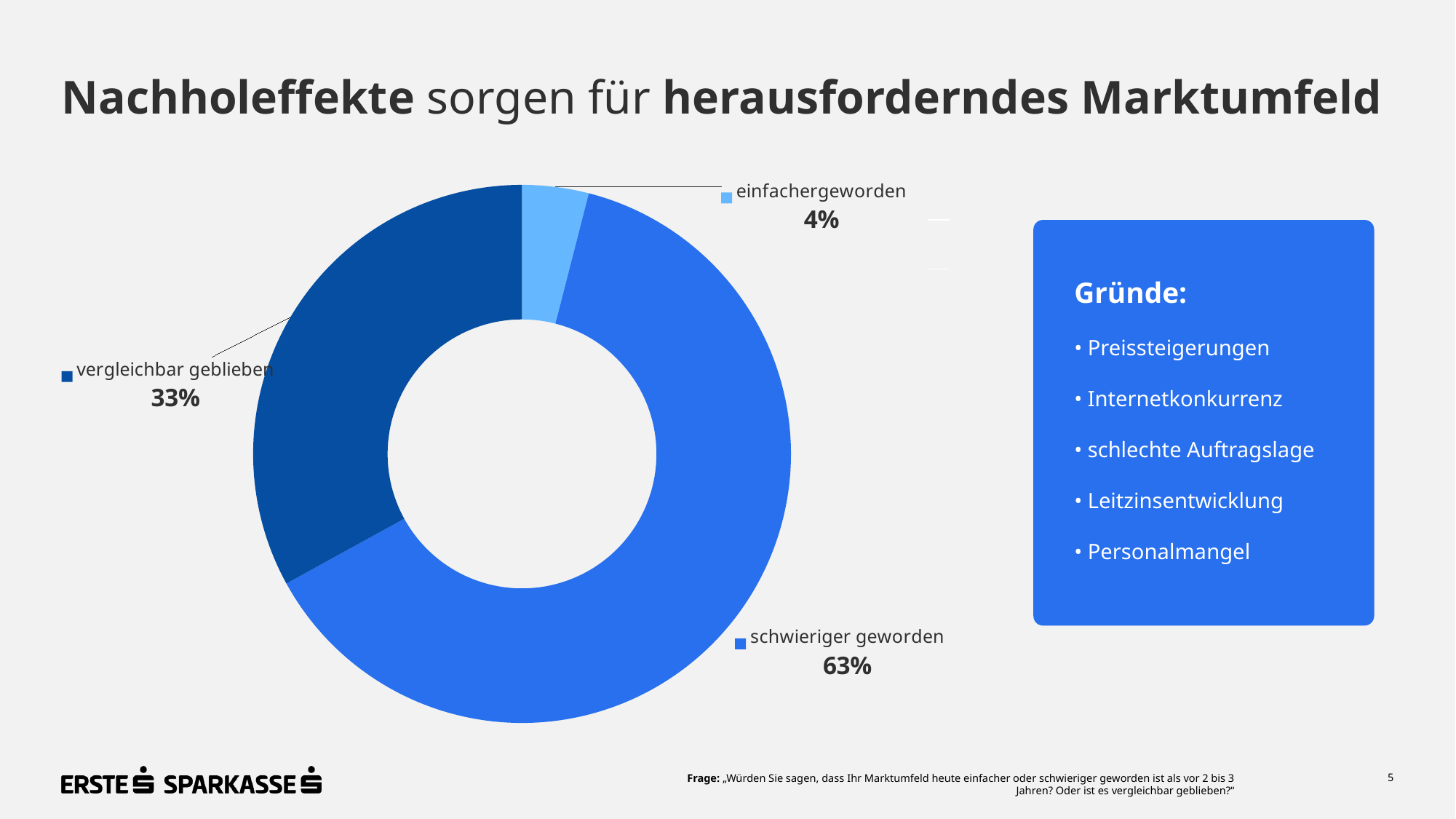
How many reasons are listed in the 'Gründe' box next to the chart? 5 What percentage of respondents said their market environment has become 'schwieriger geworden'? 63% What is the difference in percentage points between 'schwieriger geworden' and 'vergleichbar geblieben'? 30 What percentage is shown for 'einfacher geworden'? 4% What percentage is shown for 'vergleichbar geblieben'? 33% What is the difference in percentage points between 'vergleichbar geblieben' and 'einfacher geworden'? 29 Which category has the smallest share of the chart? einfacher geworden How many categories are shown in the chart? 3 Which category has the largest share of the chart? schwieriger geworden What kind of chart is shown on the slide? Doughnut (pie) chart Which is larger: the share for 'vergleichbar geblieben' or for 'einfacher geworden'? vergleichbar geblieben What is the combined share of 'schwieriger geworden' and 'vergleichbar geblieben'? 96%